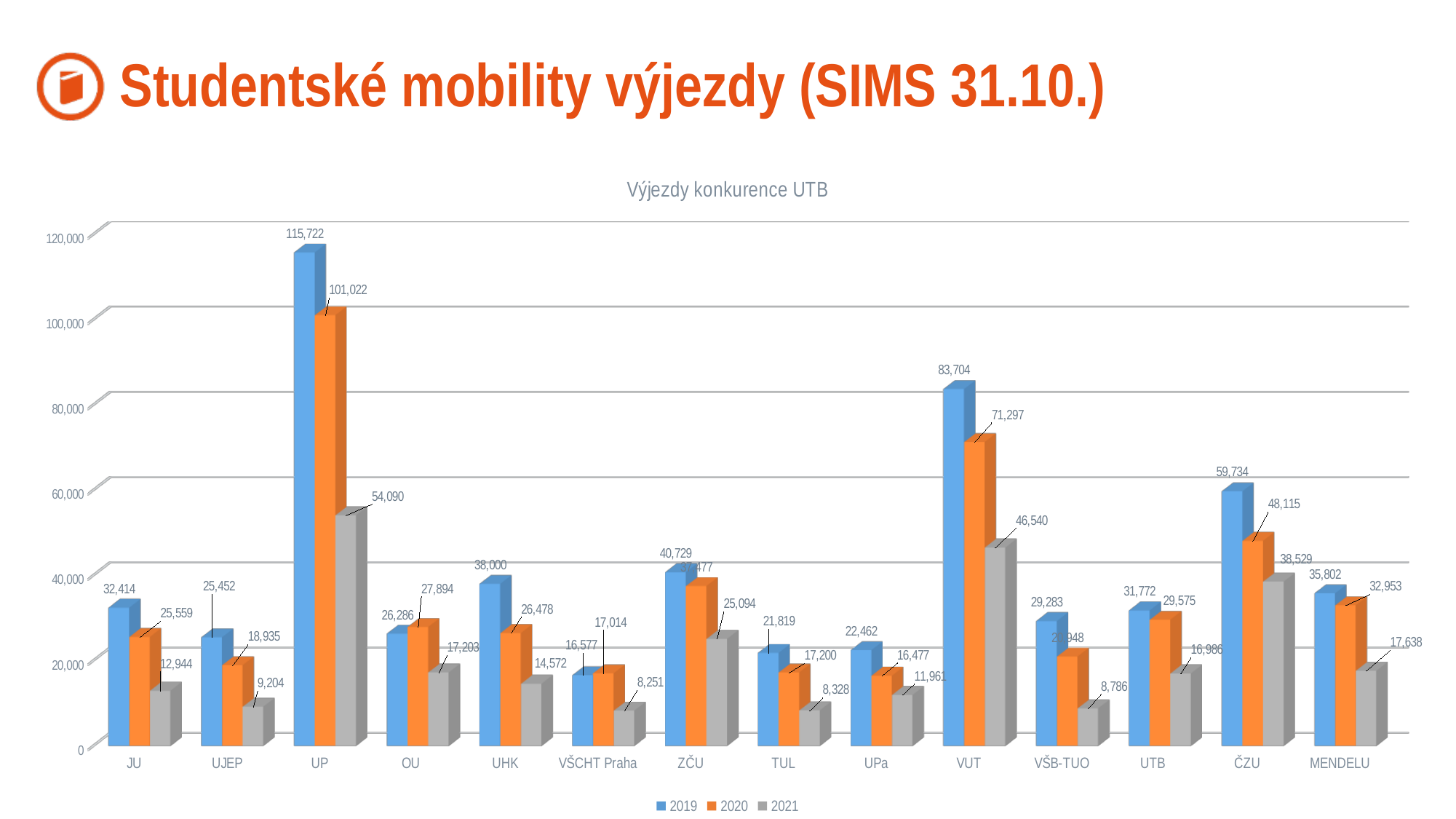
Which is larger for OU: the 2019 value or the 2020 value? 2020 What is the difference between the 2019 and 2020 values for ČZU? 11,619 What is the value for VUT in 2021? 46,540 How many universities are shown on the x axis? 14 What kind of chart is shown? bar chart What is the value for UTB in 2020? 29,575 What is the value for UP in 2019? 115,722 Is the 2019 value for VUT greater or less than 80,000? greater What is the title of the chart? Výjezdy konkurence UTB Which university has the highest value in 2019? UP Which university has the lowest value in 2021? VŠCHT Praha How many series does the legend list? 3